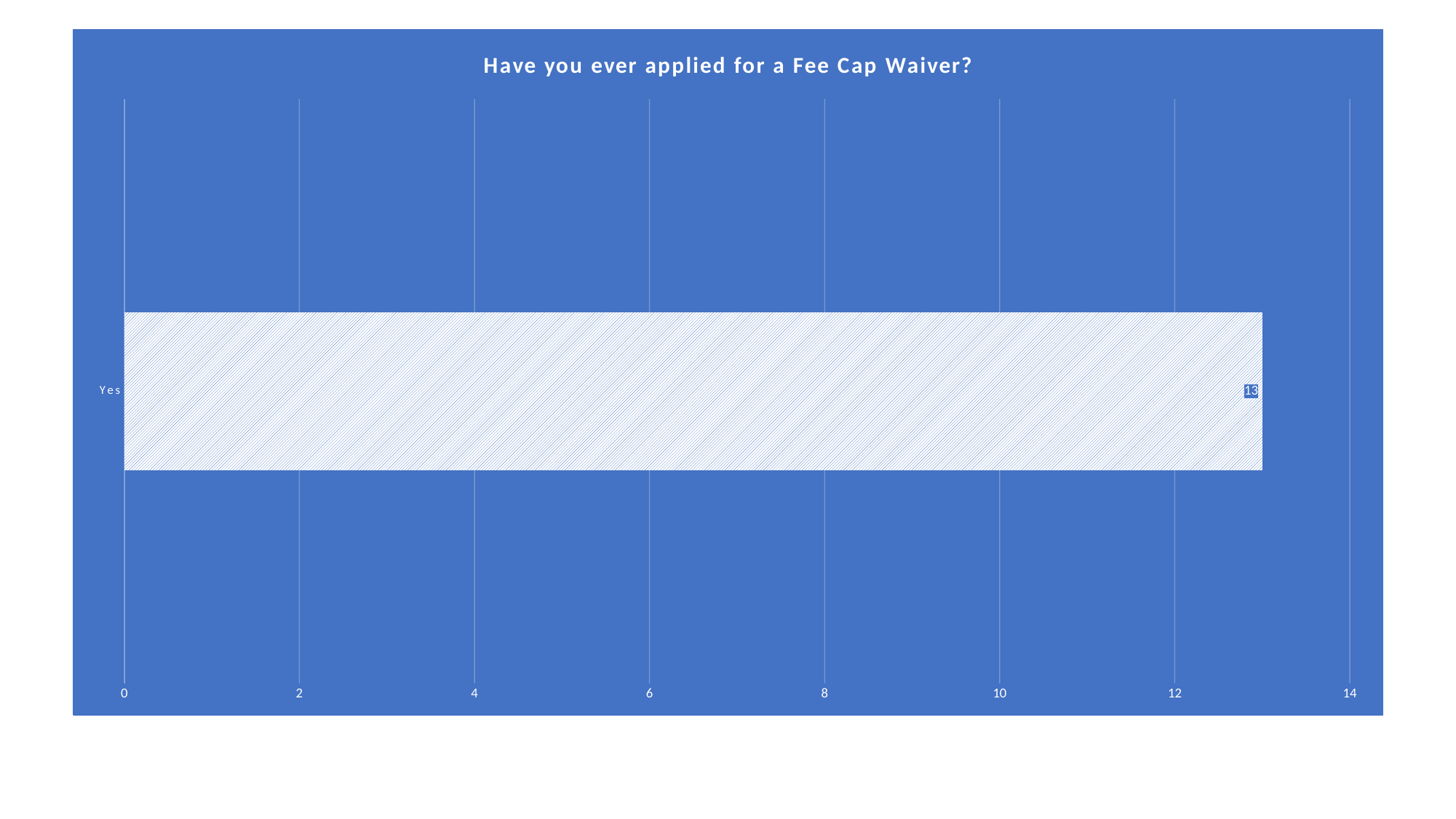
Is the value for Yes greater or less than 12? greater Is the value for Yes greater or less than 14? less How many categories are shown on the chart? 1 What is the value for Yes? 13 What kind of chart is shown on the slide? bar chart Which category is shown on the chart? Yes What is the highest value shown on the x axis? 14 What is the title of the chart? Have you ever applied for a Fee Cap Waiver?